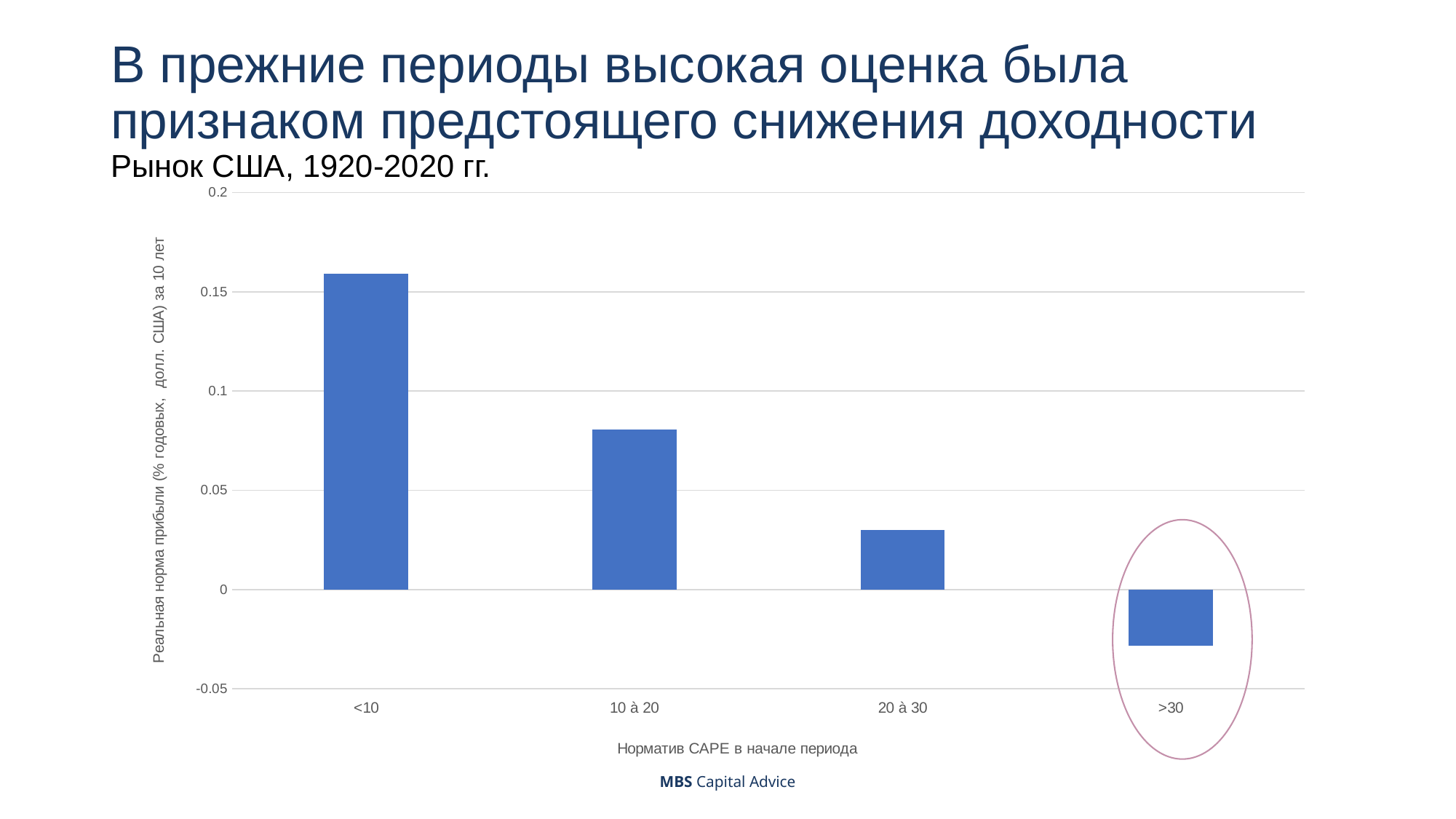
Which bar on the chart is highlighted with a circle? >30 Is the value for "20 à 30" greater or less than 0.05? less Is the value for "10 à 20" greater or less than 0.1? less What kind of chart is shown on the slide? Bar chart Which CAPE category has the lowest real rate of return? >30 Is the value for ">30" greater or less than 0? less Do the bar values rise or fall as the CAPE category increases along the x axis? Fall How many categories are shown on the x axis of the chart? 4 Which CAPE category has the highest real rate of return? <10 What is the title of the x axis of the chart? Норматив CAPE в начале периода Which has a larger value, the "10 à 20" bar or the "20 à 30" bar? 10 à 20